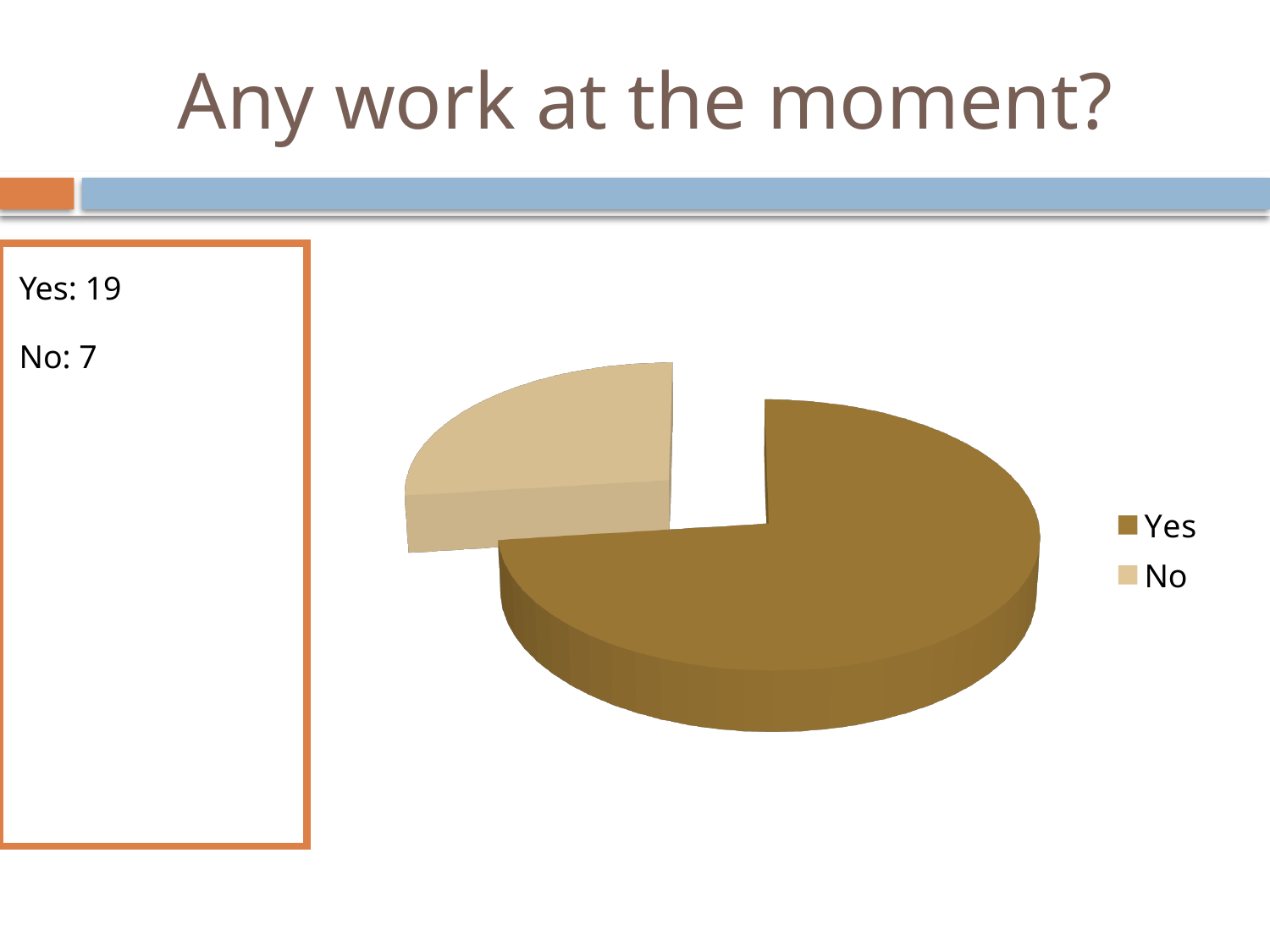
Which is larger, the value for Yes or the value for No? Yes How many entries does the legend list? 2 What is the value for No? 7 What is the difference between the Yes and No values? 12 What kind of chart is shown on the slide? pie chart How many slices does the pie chart have? 2 Which category has the smallest slice of the pie? No Which category has the largest slice of the pie? Yes What is the total of the Yes and No values? 26 Which legend entry is shown in the lighter tan colour? No What is the title of the slide containing the pie chart? Any work at the moment? What is the value for Yes? 19